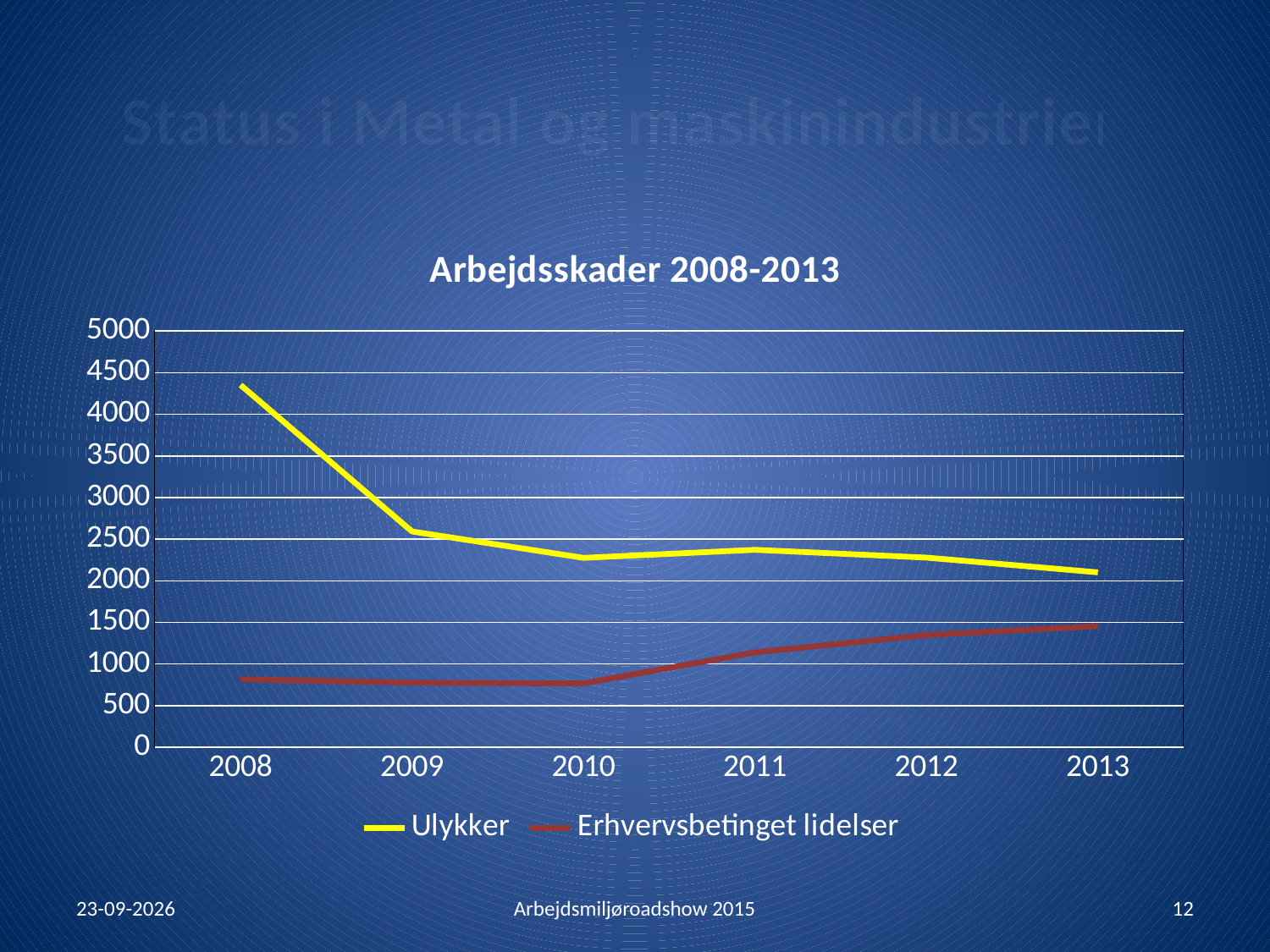
How many series does the legend list? 2 What kind of chart is shown on the slide? line chart What is the title of the chart? Arbejdsskader 2008-2013 Is the value for Ulykker in 2008 greater or less than 4000? greater Is the value for Ulykker in 2013 greater or less than 2500? less Is the value for Erhvervsbetinget lidelser in 2013 greater or less than 1000? greater How many years are shown on the x axis? 6 Which series is drawn in yellow? Ulykker In which year is the value for Ulykker highest? 2008 Which series has the larger value in 2011, Ulykker or Erhvervsbetinget lidelser? Ulykker In which year is the value for Erhvervsbetinget lidelser highest? 2013